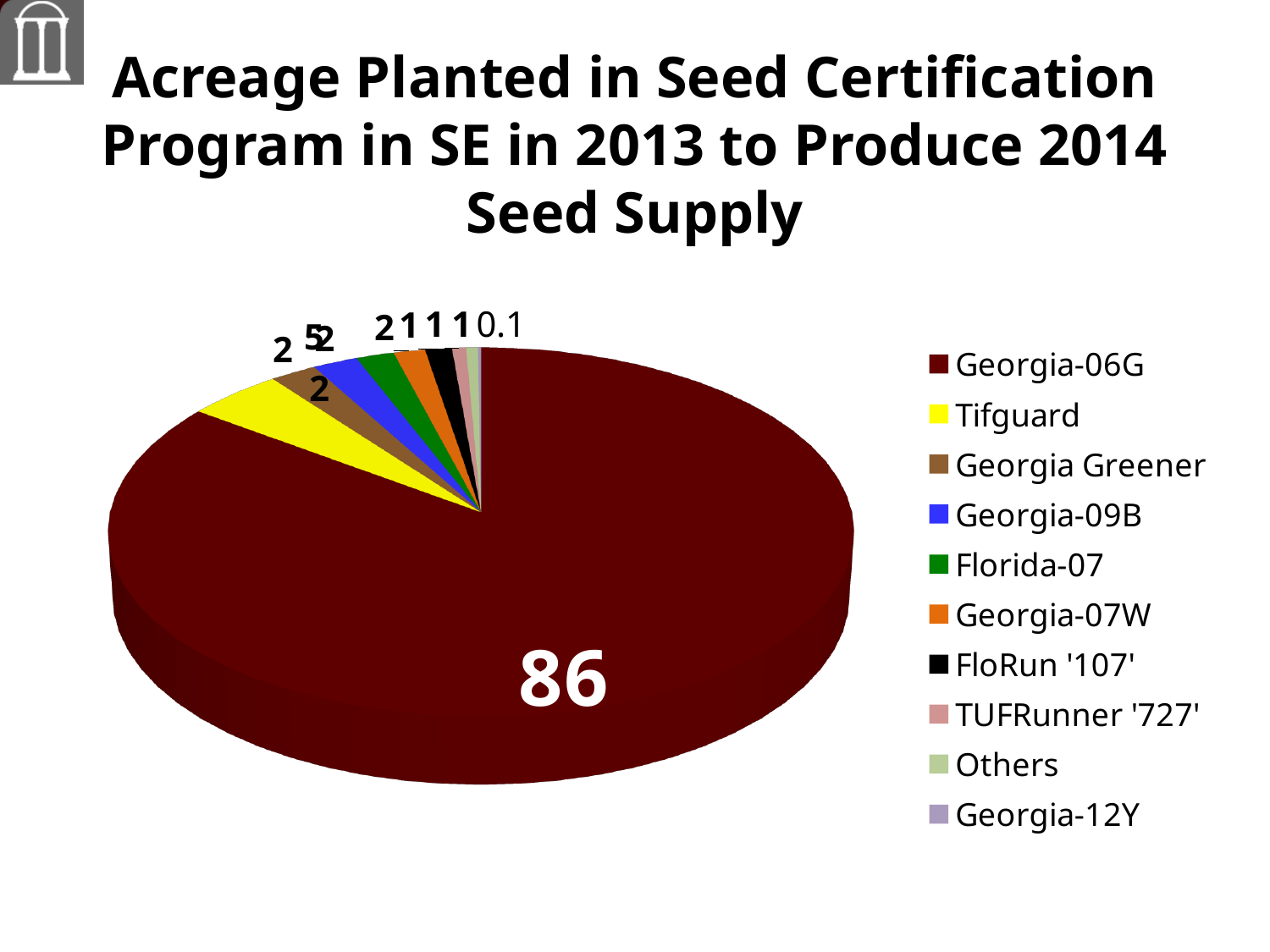
Which variety has the largest slice of the pie chart? Georgia-06G What value is shown for Georgia-12Y in the pie chart? 0.1 Which is larger, the slice for Georgia-06G or the slice for Tifguard? Georgia-06G Is the value for Georgia-06G greater or less than 50? greater How many varieties are listed in the chart legend? 10 What value is shown for Georgia-06G in the pie chart? 86 What kind of chart is shown on the slide? Pie chart What colour is the Tifguard slice in the pie chart? Yellow Which variety has the smallest slice of the pie chart? Georgia-12Y What colour is the Georgia-06G slice in the pie chart? Dark red